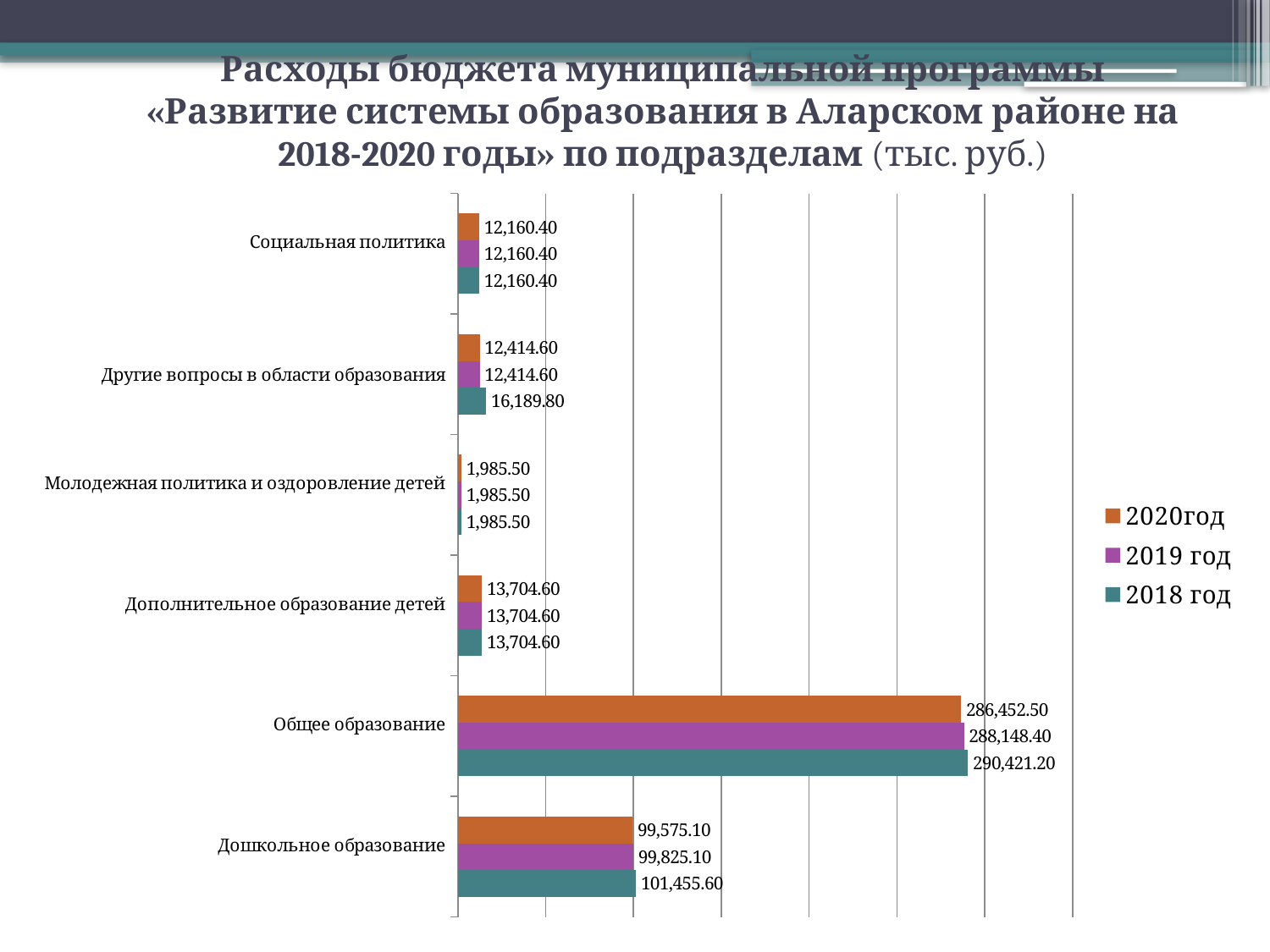
What is the value for Общее образование in 2018 год? 290,421.20 How many categories (subsections) are shown on the chart? 6 What is the value for Дошкольное образование in 2020год? 99,575.10 What is the difference between the 2018 год and 2020год values for Общее образование? 3,968.70 Which category has the lowest value in 2018 год? Молодежная политика и оздоровление детей How many series does the legend list? 3 Which category has the highest value in 2020год? Общее образование Which series is shown in orange in the legend? 2020год Which is larger for Дошкольное образование: the 2018 год value or the 2019 год value? 2018 год What kind of chart is shown on the slide? bar chart What is the value for Другие вопросы в области образования in 2018 год? 16,189.80 What is the value for Молодежная политика и оздоровление детей in 2019 год? 1,985.50